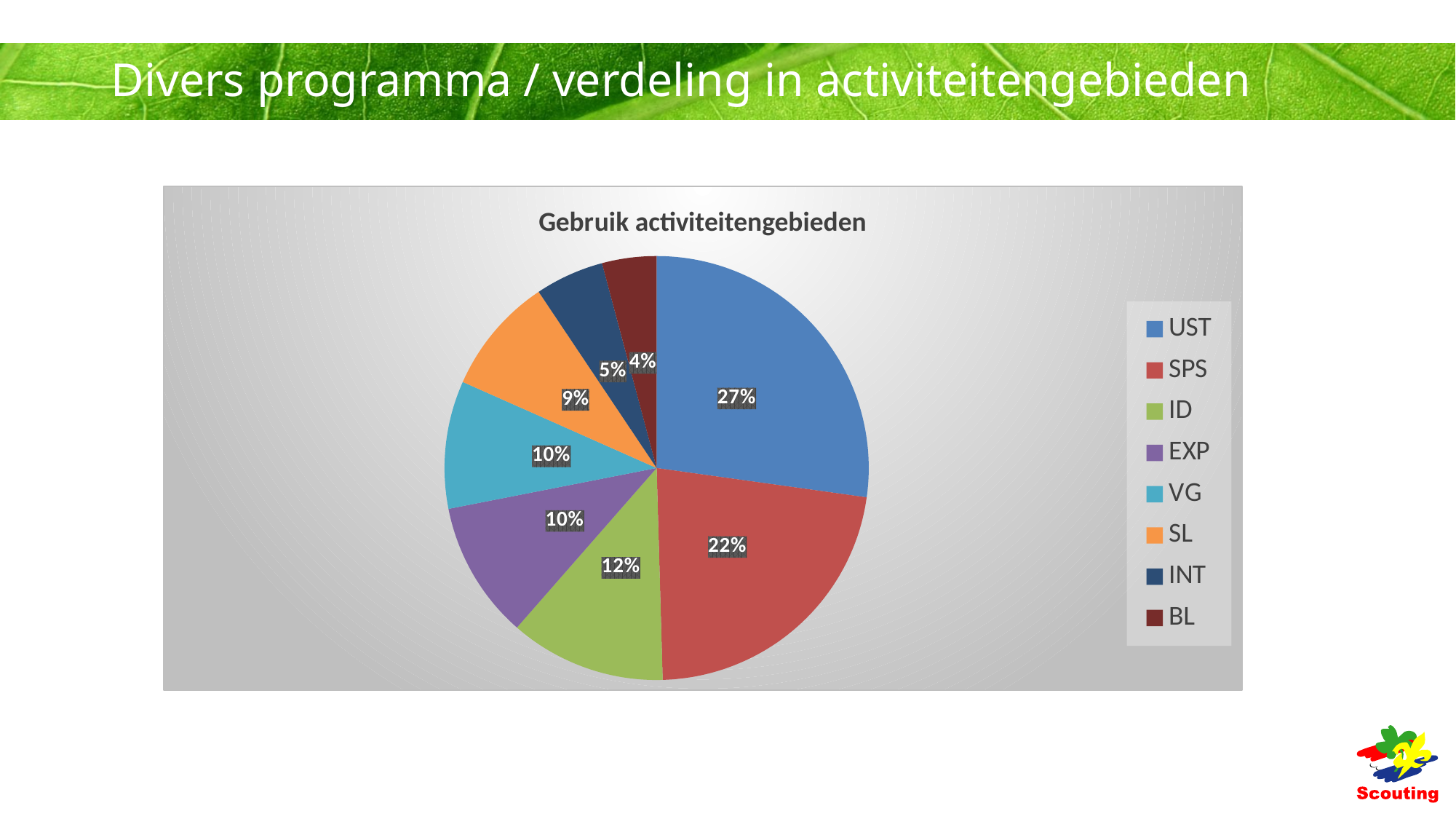
What kind of chart is shown on the slide? Pie chart Which has a larger share, INT or SL? SL Which category has the smallest share of the pie? BL What is the title of the chart? Gebruik activiteitengebieden What percentage of the pie does ID account for? 12% How many categories does the legend list? 8 Which category has the largest share of the pie? UST What percentage of the pie does SL account for? 9% What percentage of the pie does SPS account for? 22% What percentage of the pie does UST account for? 27% What percentage of the pie does BL account for? 4% What is the difference in percentage points between UST and SPS? 5